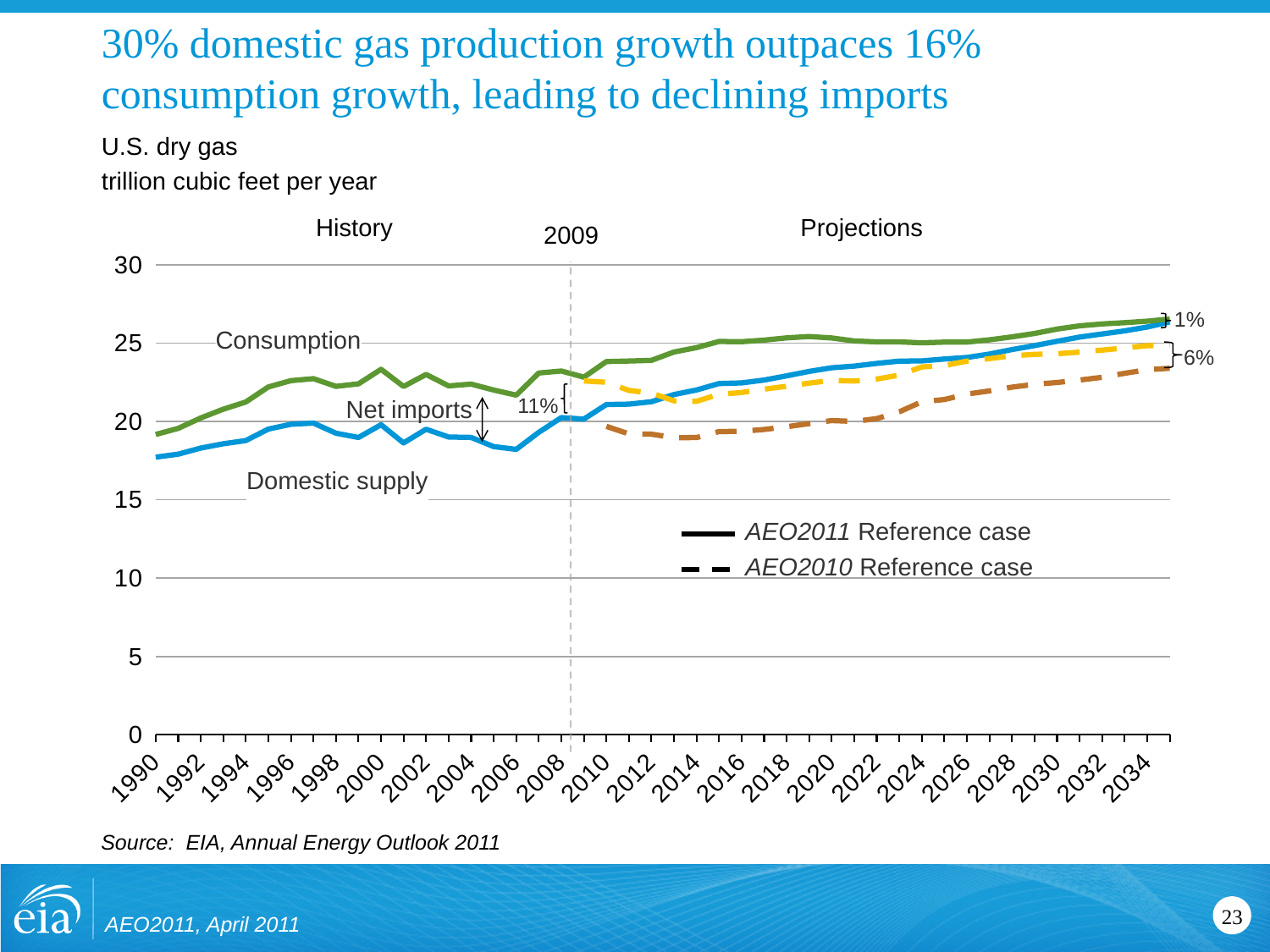
What percentage label is shown at the right end of the chart next to the domestic supply lines in 2034? 6% Is the value for Consumption in 2034 greater or less than 25? greater What percentage label is shown at the right end of the chart next to the consumption lines in 2034? 1% Which is larger in 2009, Consumption or Domestic supply? Consumption What percentage label is shown for net imports at 2009? 11% Is the value for Domestic supply in 1990 greater or less than 20? less Is the value for Consumption in 2009 greater or less than 20? greater Which year does the vertical dashed line separating History from Projections mark? 2009 Does Domestic supply rise or fall from 2009 to 2034? rise How many entries does the legend list? 2 What unit is the U.S. dry gas chart measured in? trillion cubic feet per year What kind of chart is shown on the slide? line chart